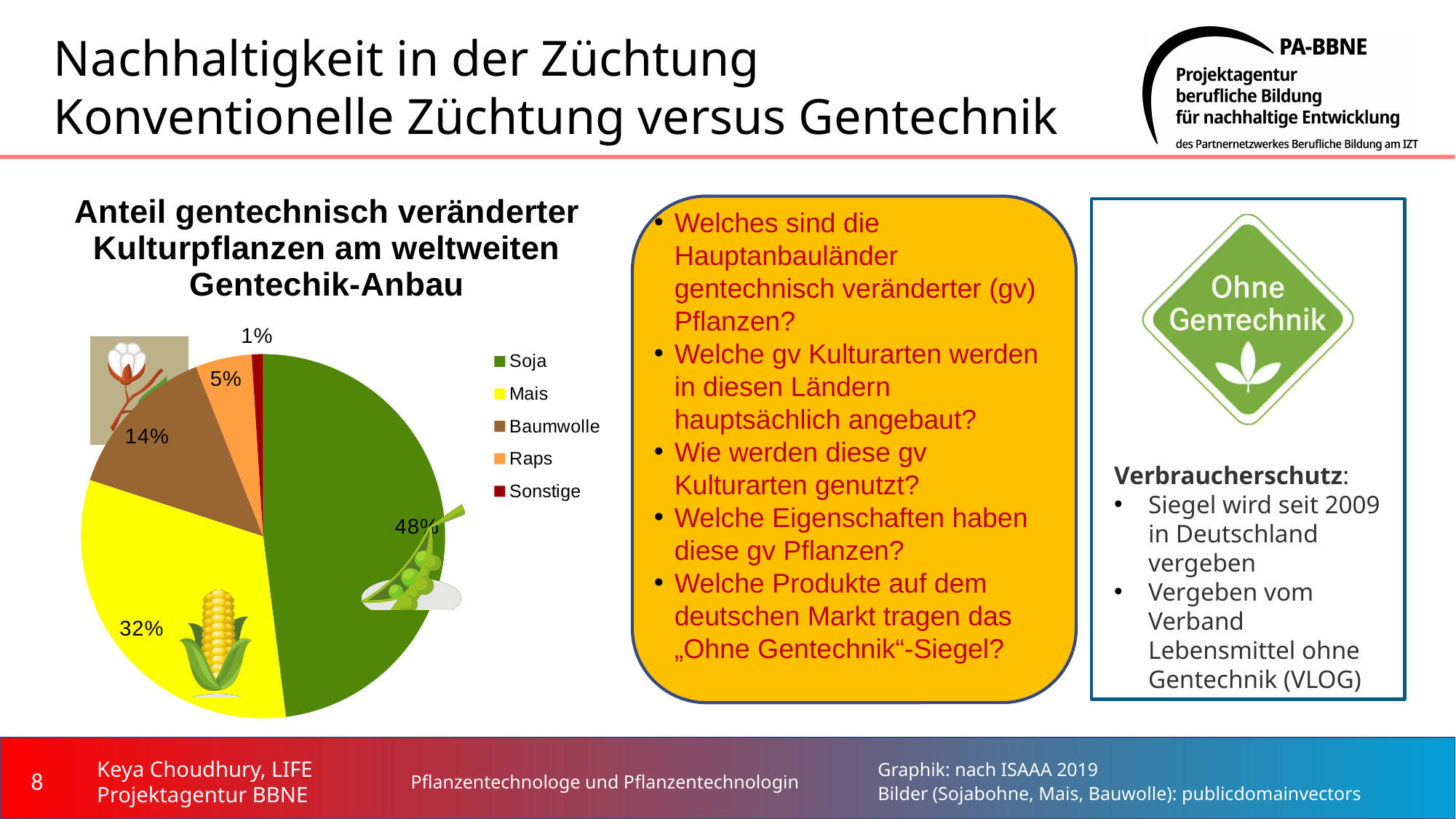
How many categories does the legend of the pie chart list? 5 Which category has the largest share of the pie? Soja What share of the pie does Mais have? 32% What is the value shown for Baumwolle? 14% Which category has the smallest share of the pie? Sonstige What is the title of the pie chart? Anteil gentechnisch veränderter Kulturpflanzen am weltweiten Gentechik-Anbau Which is larger, the share for Baumwolle or the share for Raps? Baumwolle What is the value shown for Sonstige? 1% What type of chart is shown on the slide? pie chart What is the difference in percentage points between Soja and Mais? 16 What share of the pie does Soja have? 48% What is the value shown for Raps? 5%